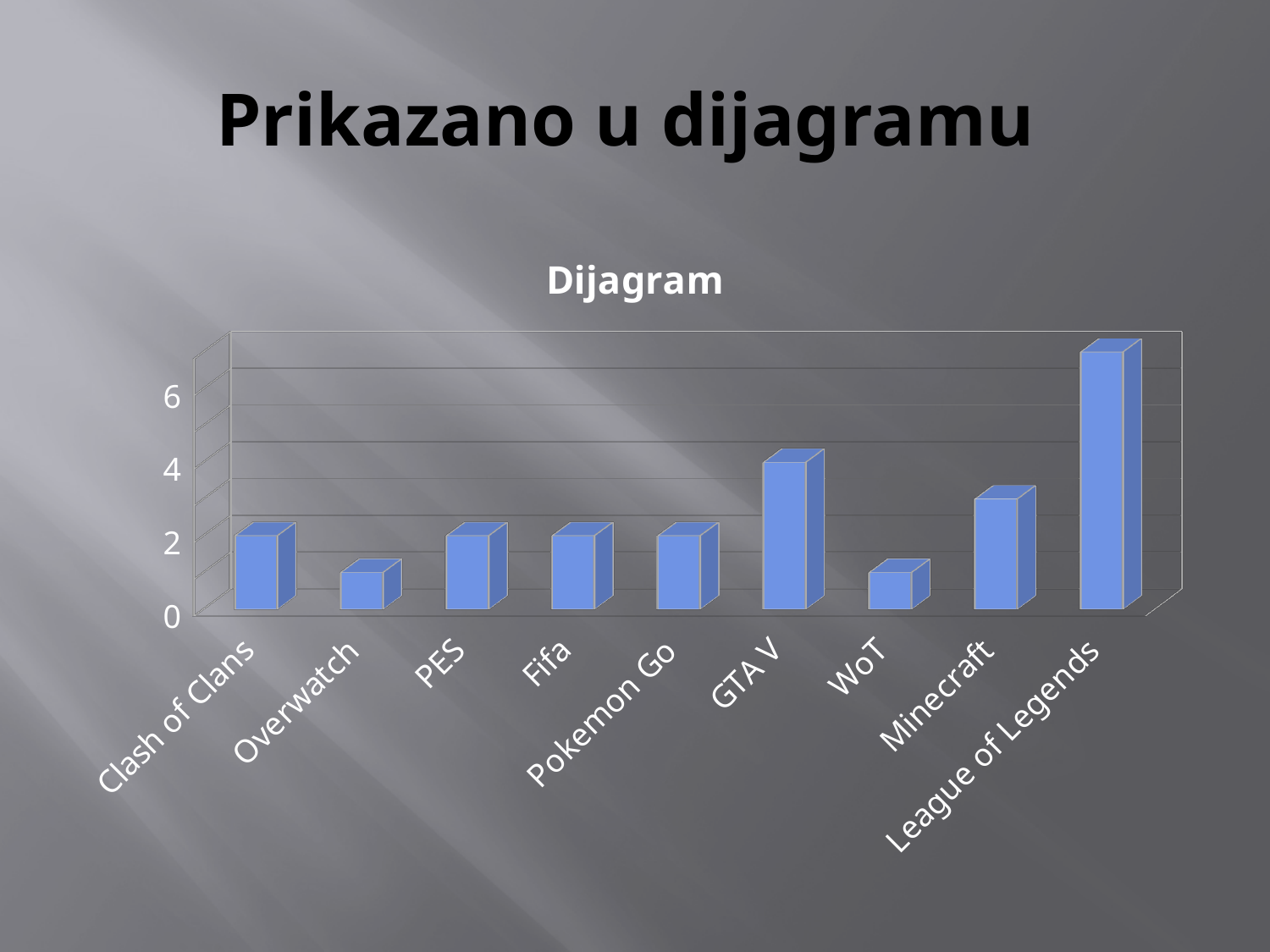
Is the value for Minecraft greater or less than 2? greater What is the value for GTA V in the chart? 4 Is the value for Overwatch greater or less than 2? less Is the value for WoT greater or less than 2? less Which is larger, the value for Pokemon Go or the value for League of Legends? League of Legends Which category has the highest bar in the chart? League of Legends What is the title of the chart? Dijagram Which is larger, the value for GTA V or the value for Minecraft? GTA V How many categories are shown on the x axis of the chart? 9 What kind of chart is shown on the slide? bar chart